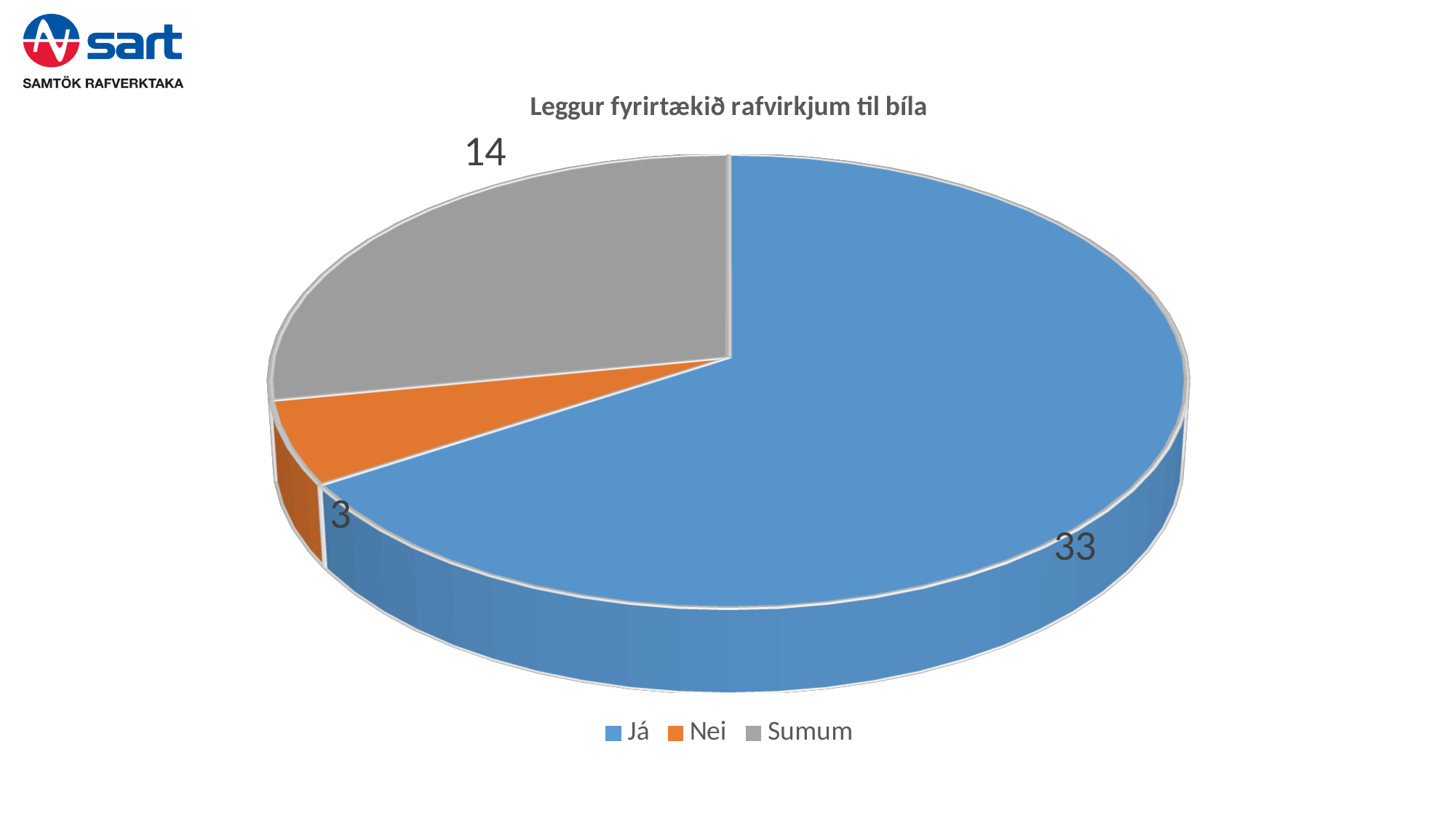
How many categories does the pie chart show? 3 What is the value for Nei? 3 What is the difference between the values for Sumum and Nei? 11 What kind of chart is shown on the slide? Pie chart Which is larger, the value for Sumum or the value for Nei? Sumum What is the value for Já? 33 What is the title of the chart? Leggur fyrirtækið rafvirkjum til bíla What share of the pie does Já represent? 66% What is the value for Sumum? 14 Which category has the smallest slice? Nei What is the difference between the values for Já and Sumum? 19 Which category has the largest slice? Já